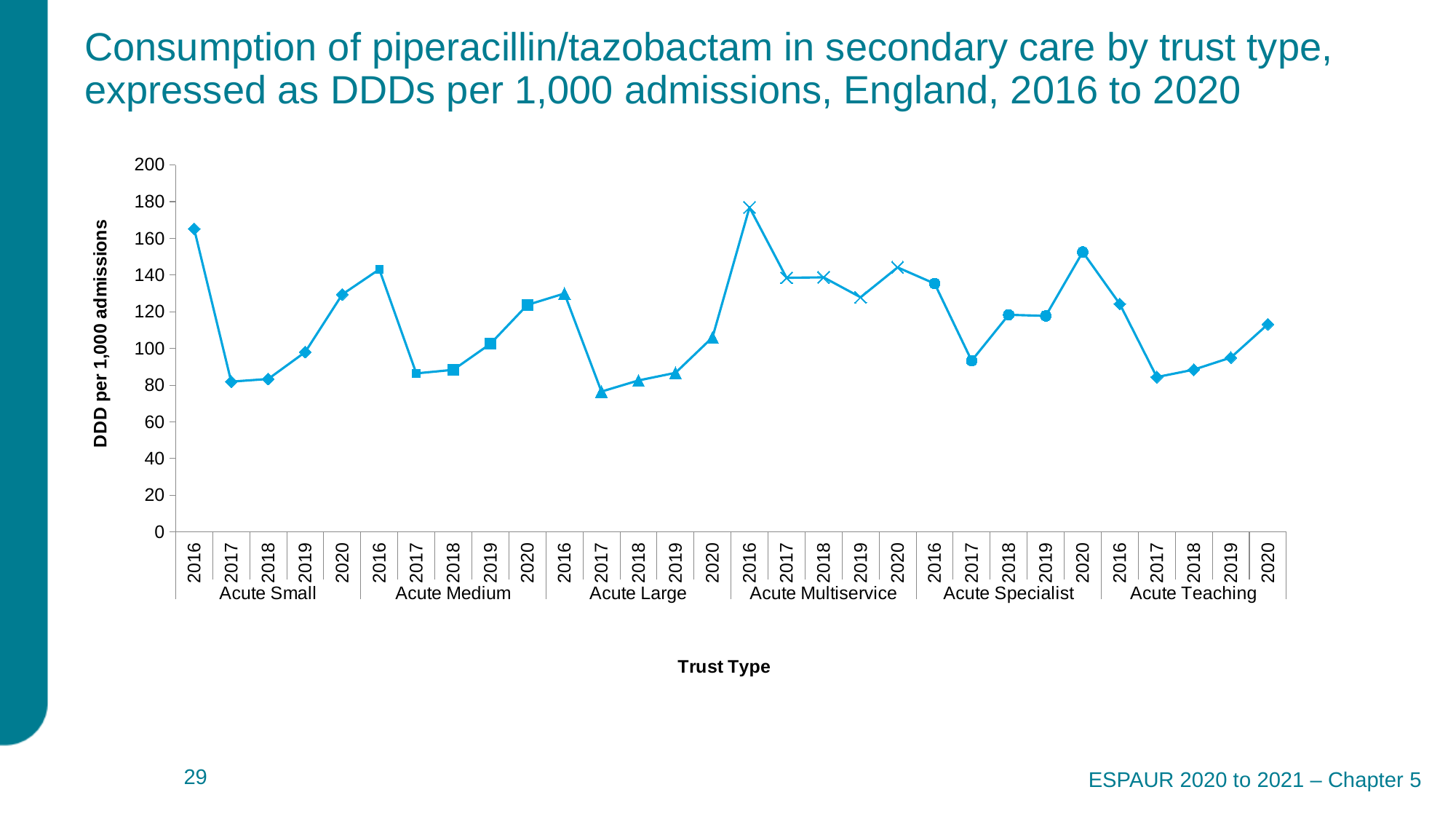
How many trust types are shown along the x axis? 6 Which trust type and year has the lowest value on the chart? Acute Large, 2017 What is the label of the y axis? DDD per 1,000 admissions Is the value for Acute Small in 2016 greater or less than 160? greater Which is larger, the value for Acute Multiservice in 2016 or the value for Acute Medium in 2016? Acute Multiservice in 2016 From 2017 to 2020, do the values for Acute Small rise or fall? rise Is the value for Acute Teaching in 2019 greater or less than 100? less What kind of chart is shown on the slide? line chart How many data points are plotted in total on the chart? 30 Is the value for Acute Large in 2017 greater or less than 80? less Which trust type and year has the highest value on the chart? Acute Multiservice, 2016